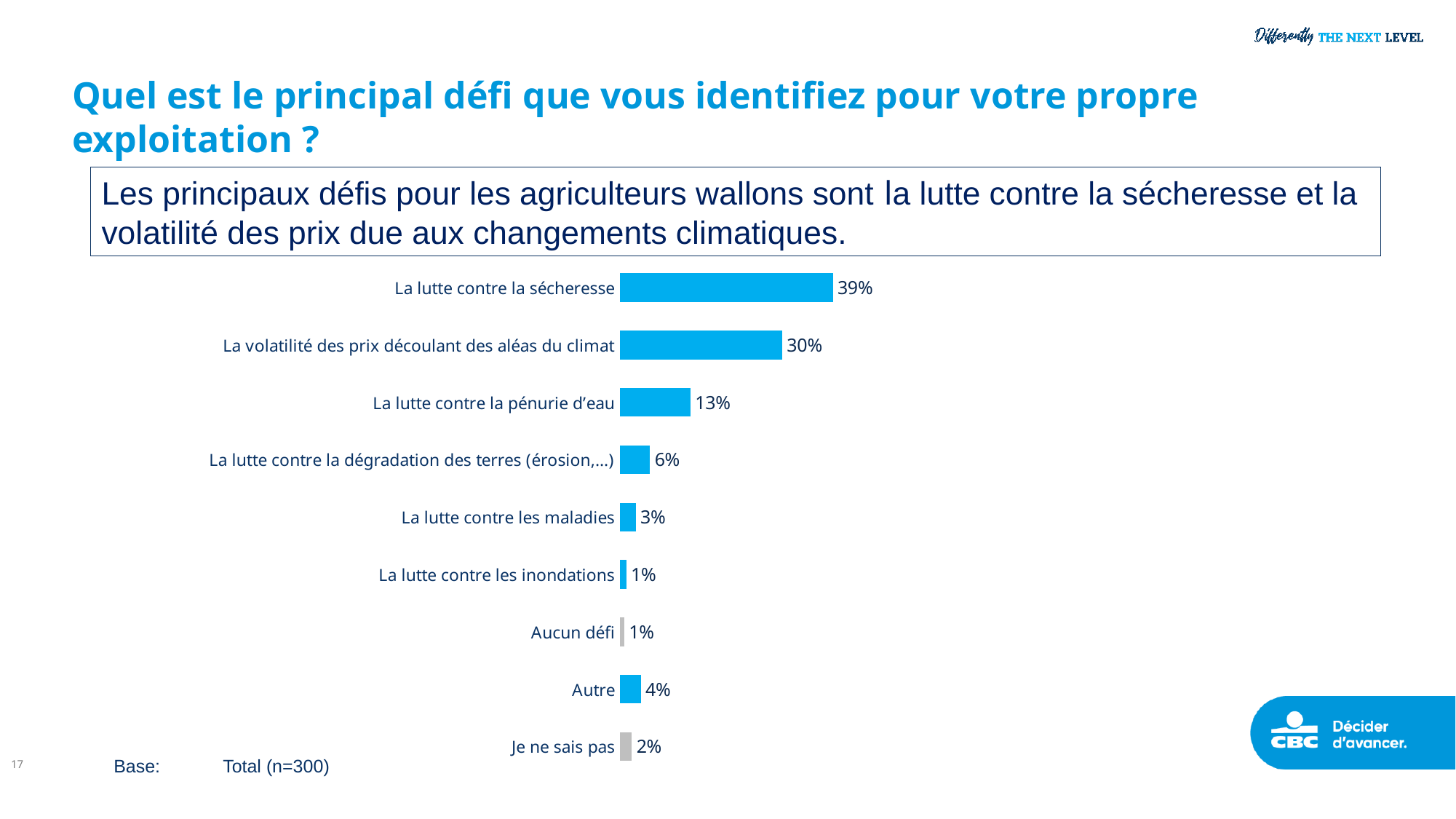
What is the value shown for "La volatilité des prix découlant des aléas du climat"? 30% How many categories are shown in the chart? 9 Which category has the highest value in the chart? La lutte contre la sécheresse What is the difference between "La lutte contre la pénurie d'eau" and "La lutte contre la dégradation des terres (érosion,...)"? 7% What percentage is shown for "Autre"? 4% What is the difference between the values for "La lutte contre la sécheresse" and "La volatilité des prix découlant des aléas du climat"? 9% What is the base (sample size) stated on the slide? Total (n=300) What is the value shown for "Je ne sais pas"? 2% What is the value shown for "La lutte contre la pénurie d'eau"? 13% What percentage of respondents identified "La lutte contre la sécheresse" as their main challenge? 39% Which is larger: the value for "La lutte contre les maladies" or the value for "Autre"? Autre What kind of chart is shown on the slide? Bar chart